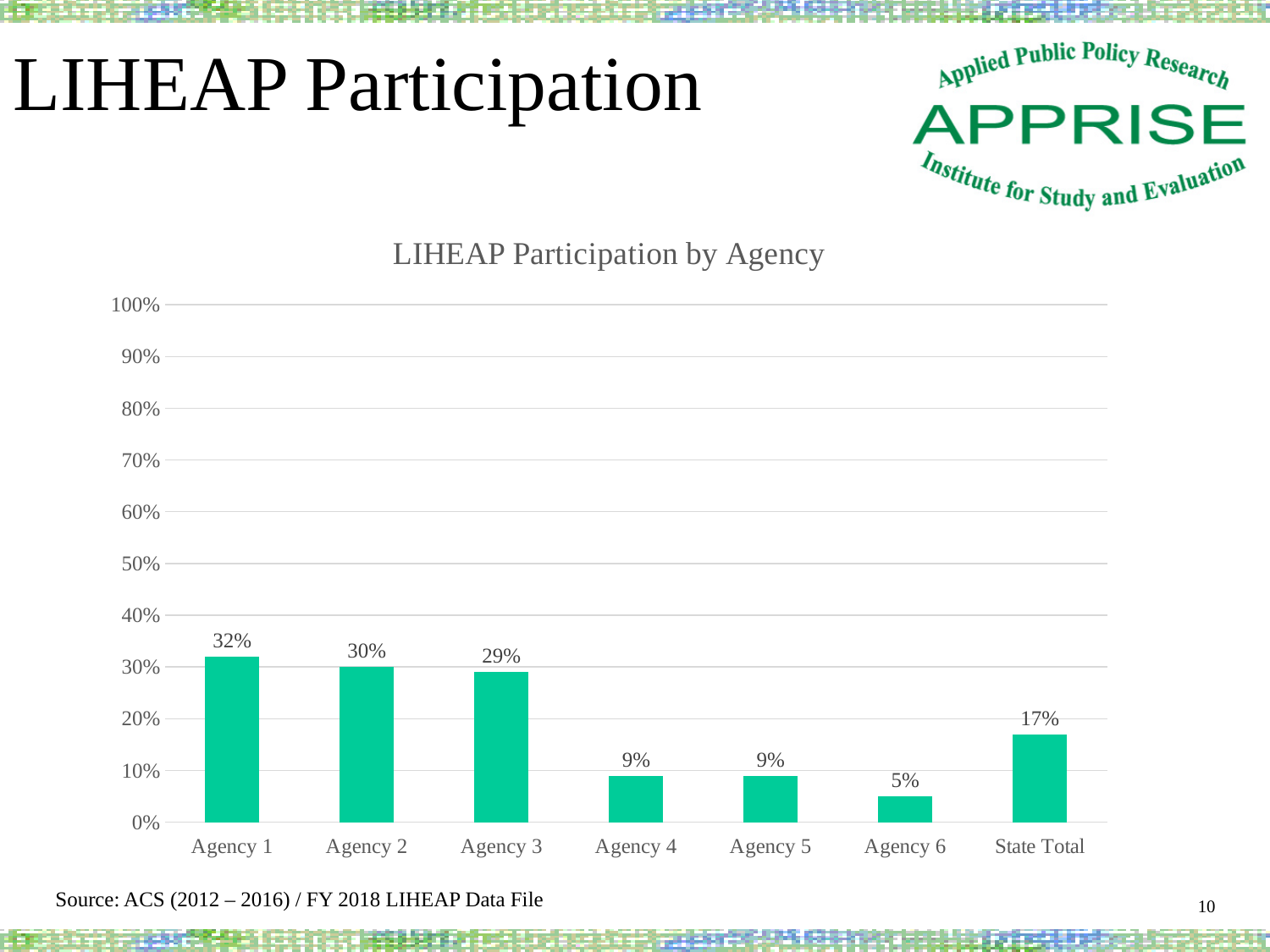
Which agency has the highest LIHEAP participation rate? Agency 1 What kind of chart is shown on the slide? Bar chart What is the title of the chart? LIHEAP Participation by Agency Which agency has the lowest LIHEAP participation rate? Agency 6 How many categories are shown on the x axis of the chart? 7 What is the State Total LIHEAP participation rate? 17% Is the value for Agency 2 greater or less than 20%? greater What is the difference between the participation rates of Agency 2 and the State Total? 13% What is the difference between the participation rates of Agency 1 and Agency 6? 27% What is the LIHEAP participation rate for Agency 6? 5% What is the LIHEAP participation rate for Agency 1? 32% Which has a higher participation rate, Agency 3 or Agency 4? Agency 3